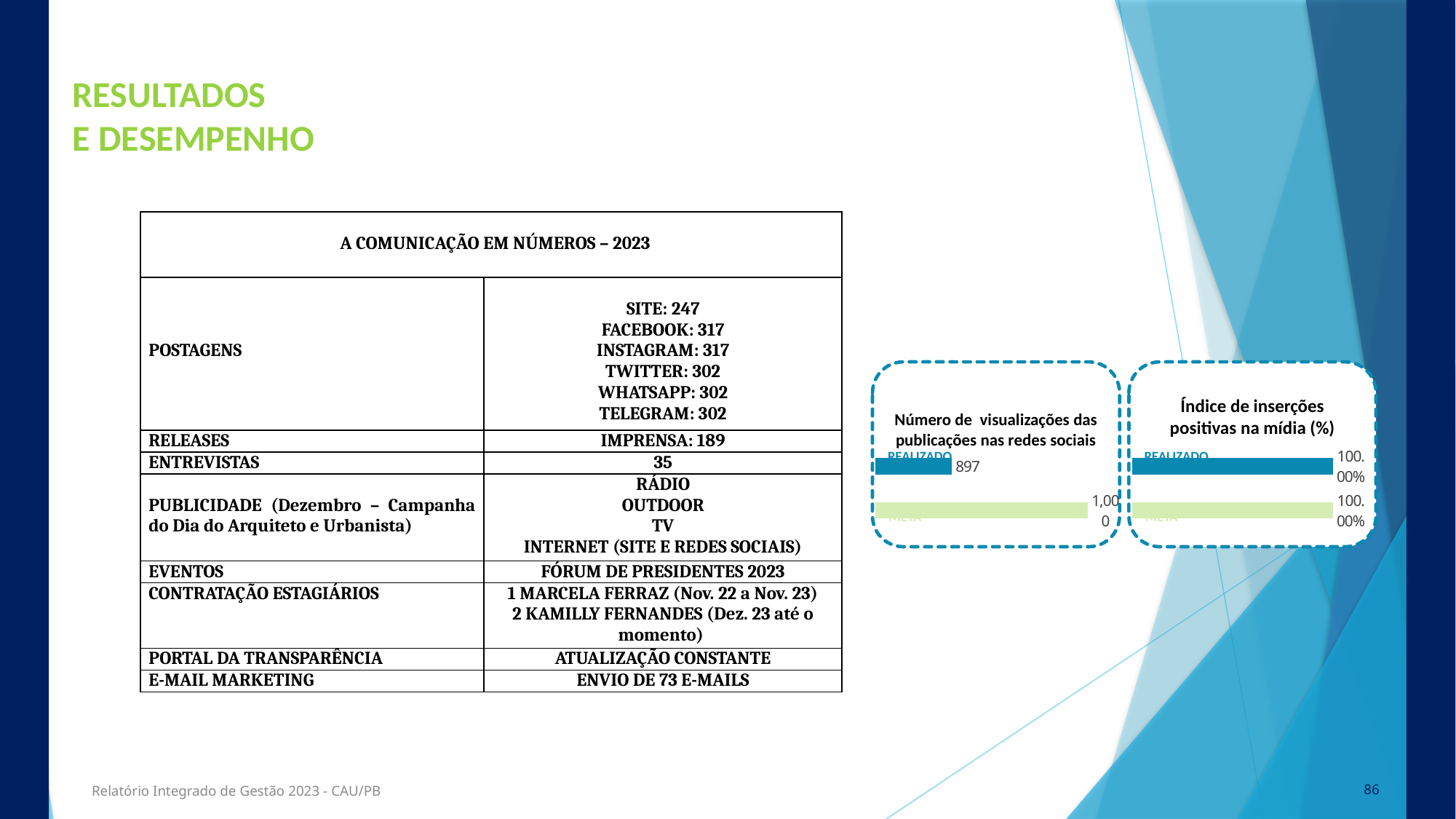
In the chart titled "Número de visualizações das publicações nas redes sociais", what is the value for META? 1,000 How many charts are shown on the slide? 2 In the chart titled "Número de visualizações das publicações nas redes sociais", how many bars are plotted? 2 In the chart titled "Índice de inserções positivas na mídia (%)", what is the difference between REALIZADO and META? 0.00% In the chart titled "Índice de inserções positivas na mídia (%)", what is the value for META? 100.00% What kind of chart is "Número de visualizações das publicações nas redes sociais"? Bar chart In the chart titled "Número de visualizações das publicações nas redes sociais", what is the value for REALIZADO? 897 In the chart titled "Índice de inserções positivas na mídia (%)", how many bars are plotted? 2 In the chart titled "Índice de inserções positivas na mídia (%)", what colour is the REALIZADO bar? Blue In the chart titled "Número de visualizações das publicações nas redes sociais", what is the difference between META and REALIZADO? 103 In the chart titled "Índice de inserções positivas na mídia (%)", what is the value for REALIZADO? 100.00% In the chart titled "Número de visualizações das publicações nas redes sociais", which bar is longer, REALIZADO or META? META